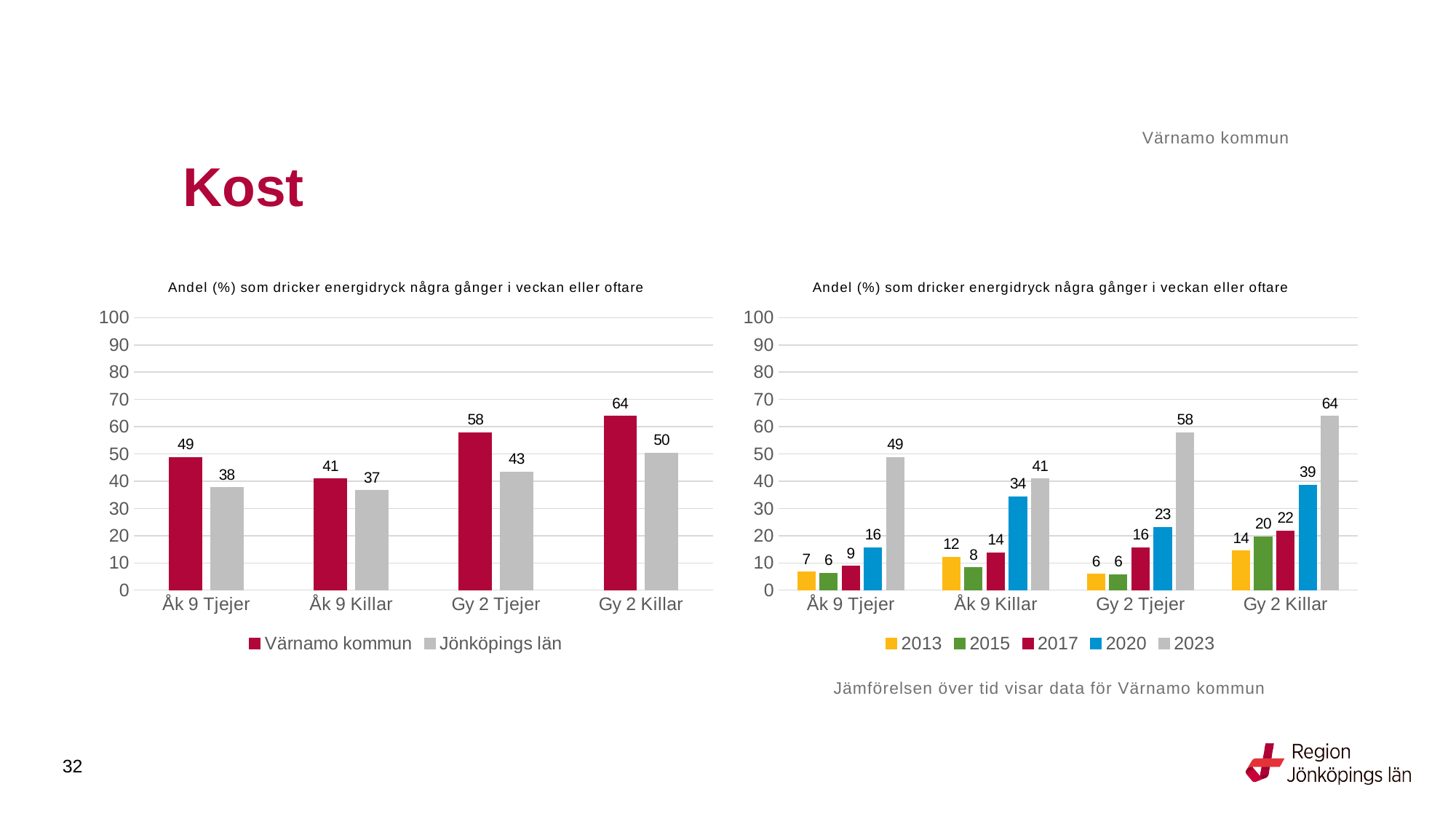
In the left chart, what is the difference between Värnamo kommun and Jönköpings län for Gy 2 Killar? 14 In the left chart, what is the value for Jönköpings län for Åk 9 Killar? 37 In the right chart, is the value for 2023 for Gy 2 Tjejer larger than the value for 2020 for Gy 2 Tjejer? Yes In the right chart, what is the value for 2013 for Gy 2 Killar? 14 In the right chart, which year has the lowest value for Åk 9 Tjejer? 2015 In the right chart, what is the value for 2020 for Åk 9 Killar? 34 In the left chart, what is the value for Värnamo kommun for Gy 2 Tjejer? 58 In the left chart, how many series does the legend list? 2 What kind of chart is the left chart? Bar chart In the right chart, how many series does the legend list? 5 In the left chart, which category has the highest value for Värnamo kommun? Gy 2 Killar In the right chart, do the values for Gy 2 Killar rise or fall from 2013 to 2023? Rise